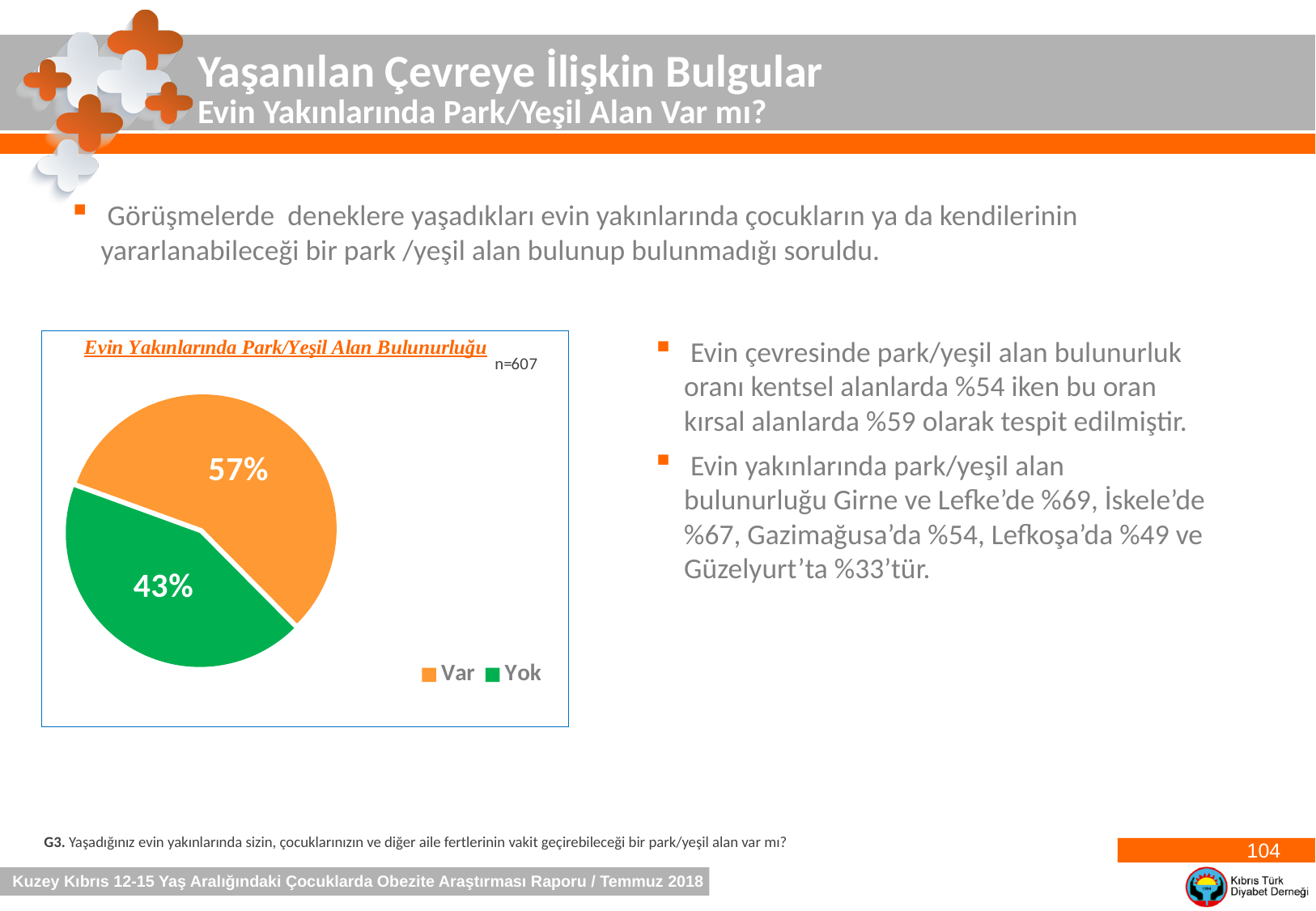
Which slice of the pie chart is the smallest? Yok How many slices does the pie chart have? 2 What is the title of the pie chart? Evin Yakınlarında Park/Yeşil Alan Bulunurluğu How many entries does the legend of the pie chart list? 2 Which is larger, the "Var" slice or the "Yok" slice? Var What is the difference between the "Var" and "Yok" slices? 14% What is the value for "Var" in the pie chart? 57% What sample size (n) is shown on the pie chart? n=607 Which slice of the pie chart is the largest? Var What is the value for "Yok" in the pie chart? 43% What kind of chart is shown on the slide? pie chart What share of the pie does the "Yok" slice represent? 43%